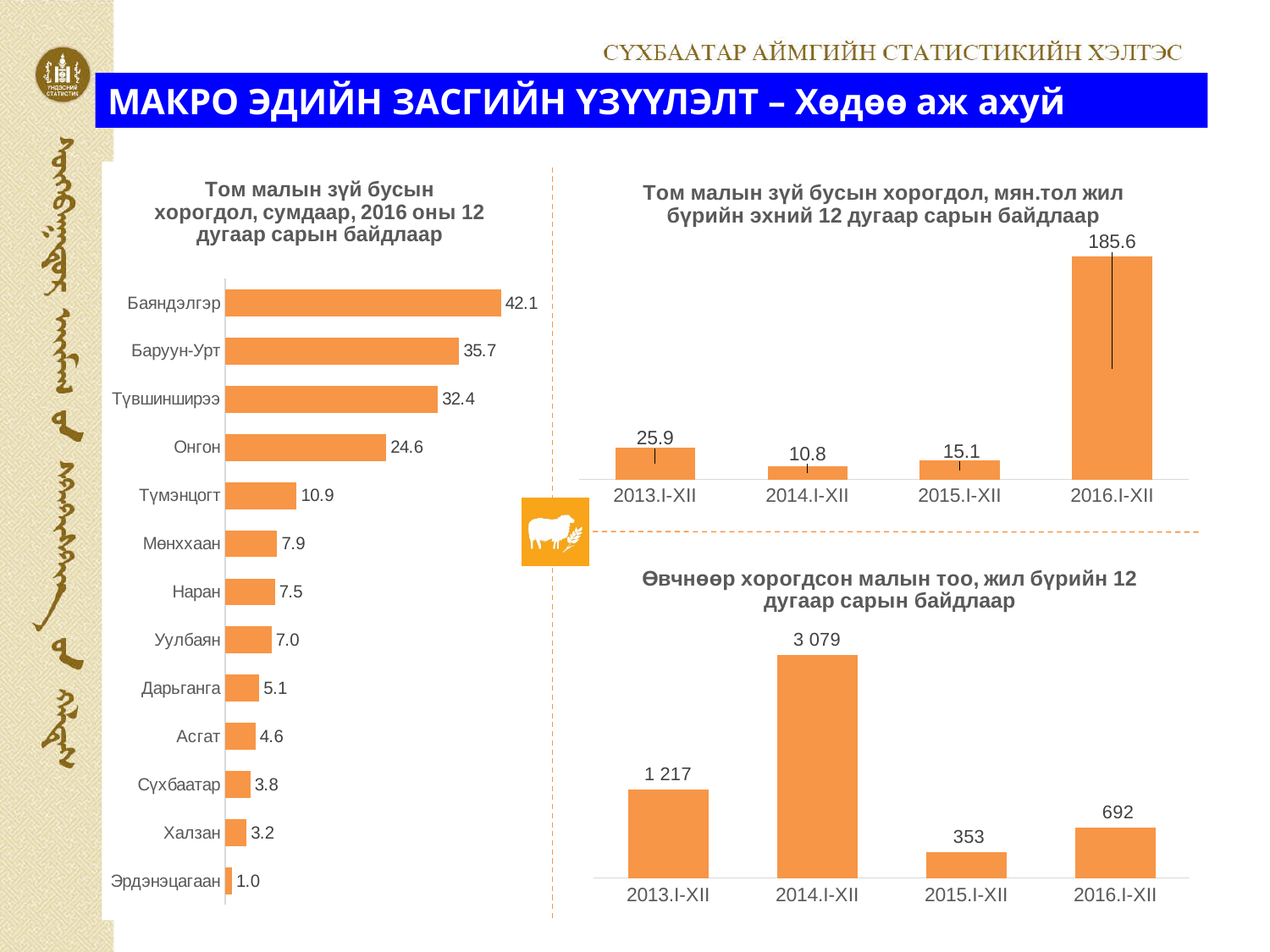
In the bottom-right chart (Өвчнөөр хорогдсон малын тоо), what is the value for 2014.I-XII? 3 079 In the left chart (Том малын зүй бусын хорогдол, сумдаар), which soum has the lowest value? Эрдэнэцагаан In the left chart (Том малын зүй бусын хорогдол, сумдаар), what is the difference between Баруун-Урт and Түвшинширээ? 3.3 In the bottom-right chart (Өвчнөөр хорогдсон малын тоо), which year has the lowest value? 2015.I-XII What type of chart is the left chart (Том малын зүй бусын хорогдол, сумдаар)? Bar chart In the left chart (Том малын зүй бусын хорогдол, сумдаар), which is larger, Онгон or Түмэнцогт? Онгон In the top-right chart (Том малын зүй бусын хорогдол, мян.тол), what is the difference between 2015.I-XII and 2014.I-XII? 4.3 In the bottom-right chart (Өвчнөөр хорогдсон малын тоо), what is the difference between 2013.I-XII and 2016.I-XII? 525 In the top-right chart (Том малын зүй бусын хорогдол, мян.тол), which year has the lowest value? 2014.I-XII In the top-right chart (Том малын зүй бусын хорогдол, мян.тол), what is the value for 2016.I-XII? 185.6 In the left chart (Том малын зүй бусын хорогдол, сумдаар), what is the value for Баяндэлгэр? 42.1 In the left chart (Том малын зүй бусын хорогдол, сумдаар), how many soums are listed? 13